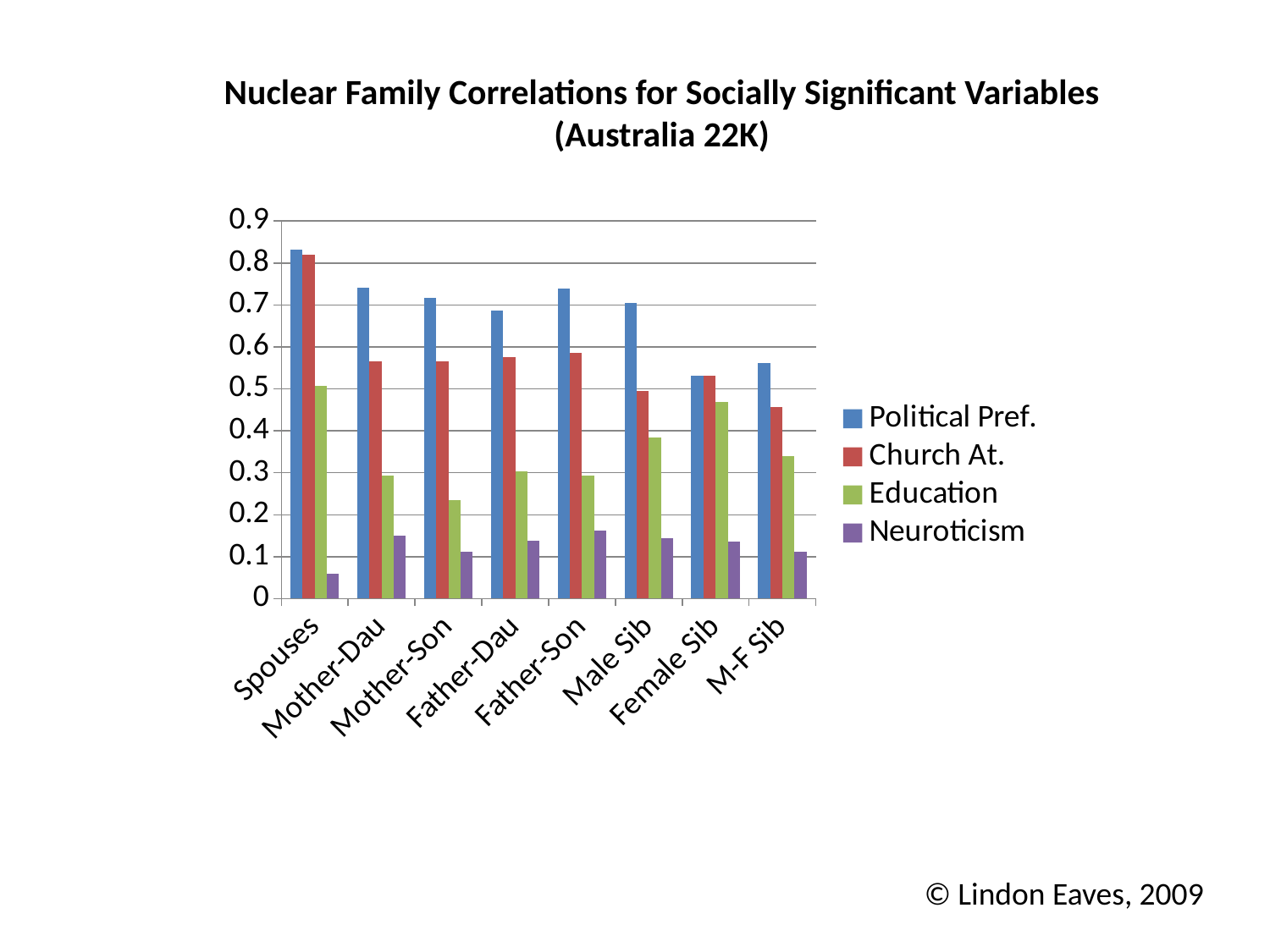
Which category has the lowest Education correlation? Mother-Son Is the Political Pref. value for Spouses greater or less than 0.8? greater Which series is shown in green in the legend? Education How many series does the legend list? 4 Which category has the highest Political Pref. correlation? Spouses How many family relationship categories are shown on the x axis? 8 For Male Sib, which is larger: the Political Pref. value or the Education value? Political Pref. Is the Church At. value for M-F Sib greater or less than 0.5? less Is the Education value for Mother-Son greater or less than 0.3? less Which category has the lowest Neuroticism correlation? Spouses What kind of chart is shown on the slide? Bar chart